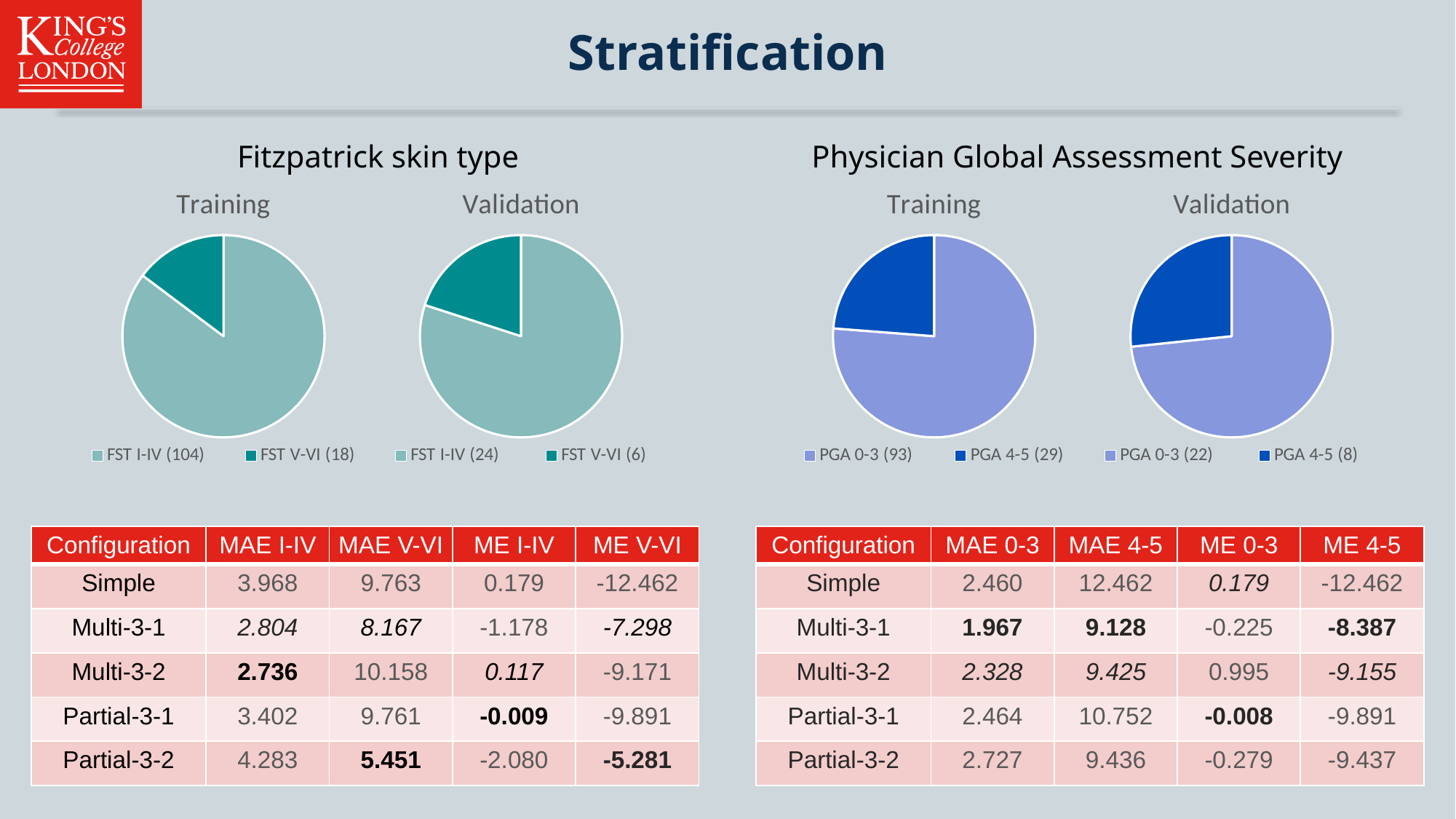
On the Fitzpatrick skin type Validation pie chart, how many cases are in the FST V-VI group according to the legend? 6 On the Physician Global Assessment Severity Validation pie chart, which group has the smallest slice? PGA 4-5 On the Fitzpatrick skin type Training pie chart, what is the difference between the FST I-IV count and the FST V-VI count? 86 On the Fitzpatrick skin type Validation pie chart, what share of the pie does the FST V-VI slice represent? 20% On the Physician Global Assessment Severity Validation pie chart, how many cases are in the PGA 0-3 group according to the legend? 22 How many slices does the Fitzpatrick skin type Validation pie chart have? 2 How many pie charts are shown on the slide in total? 4 What type of chart is used to show the Physician Global Assessment Severity Training data? Pie chart On the Fitzpatrick skin type Training pie chart, which group has the largest slice? FST I-IV On the Fitzpatrick skin type Training pie chart, how many cases are in the FST I-IV group according to the legend? 104 On the Physician Global Assessment Severity Training pie chart, how many cases are in the PGA 4-5 group according to the legend? 29 On the Physician Global Assessment Severity Training pie chart, what is the difference between the PGA 0-3 count and the PGA 4-5 count? 64